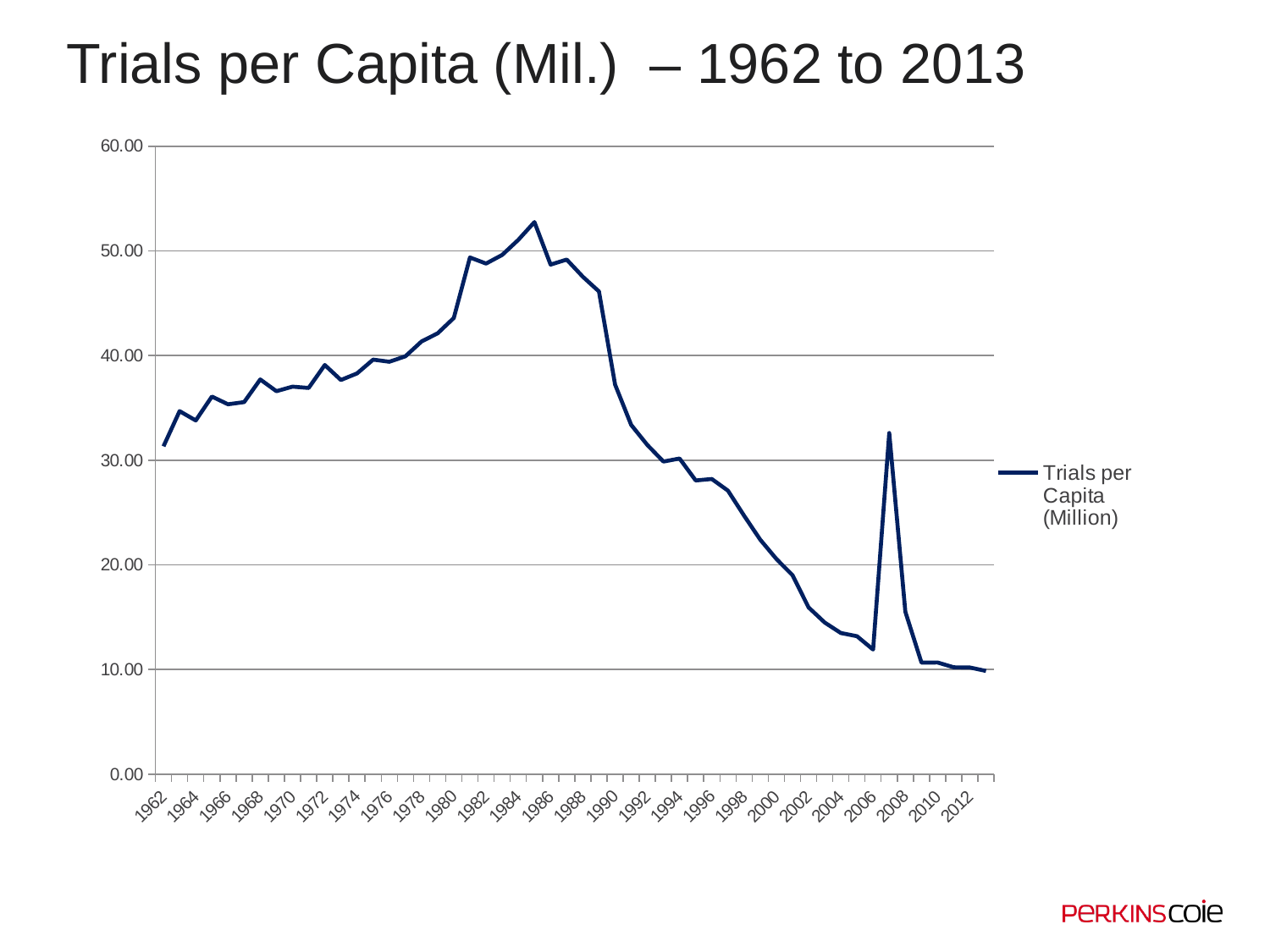
What is the name of the series shown in the legend? Trials per Capita (Million) Which year has the larger value, 2006 or 2007? 2007 What is the title of the chart? Trials per Capita (Mil.) – 1962 to 2013 Is the value for 2005 greater or less than 20.00? less Is the value for 1980 greater or less than 40.00? greater What kind of chart is shown on the slide? line chart Is the value for 1962 greater or less than 30.00? greater In which year does the line reach its highest value? 1985 Do the values generally rise or fall from 1985 to 2006? fall How many series does the legend list? 1 Which year has the larger value, 1962 or 1985? 1985